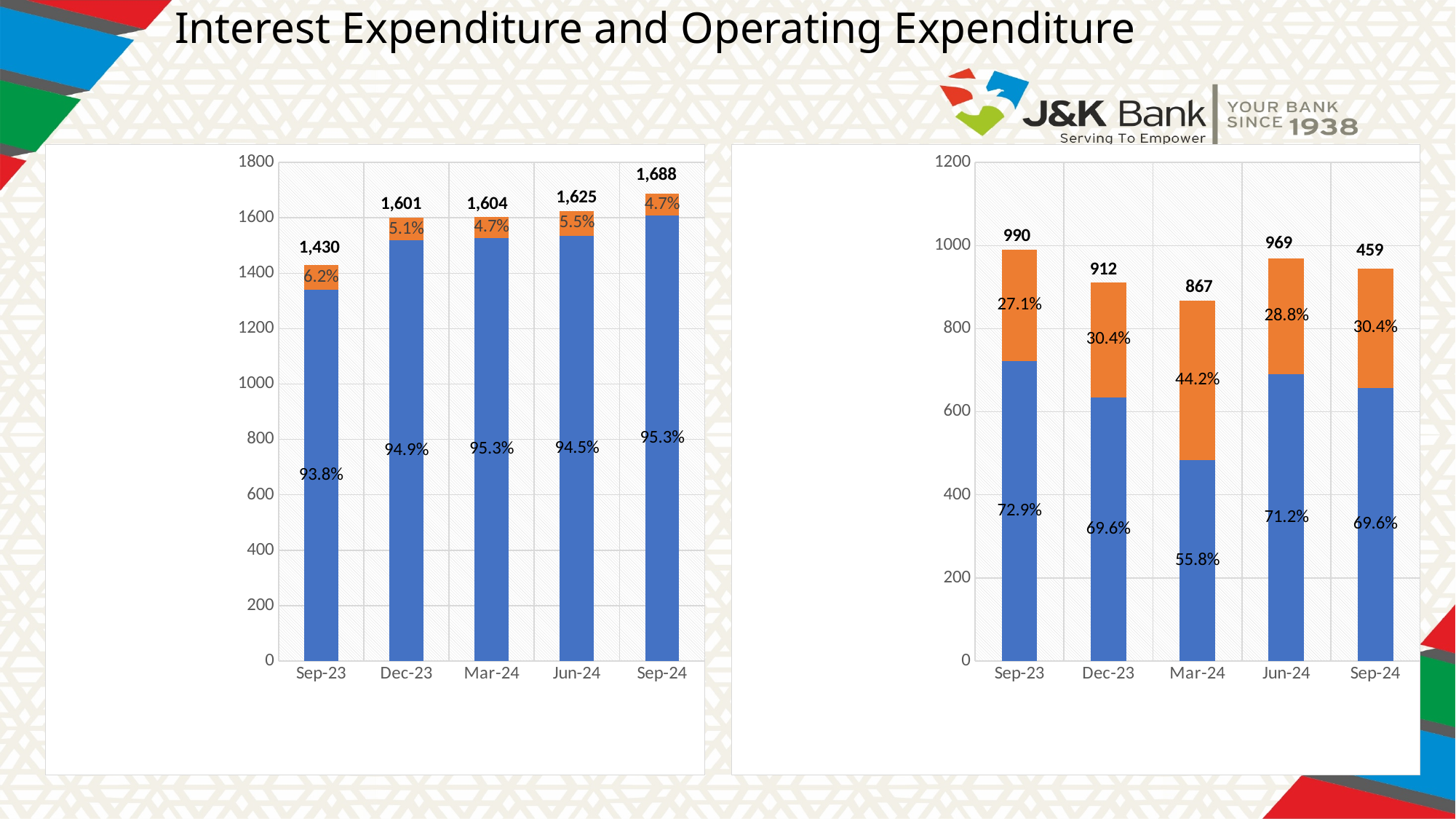
In the right chart, what percentage is labelled on the orange segment for Mar-24? 44.2% In the right chart, what is the total value labelled for Sep-23? 990 In the left chart, what is the total value labelled for Sep-24? 1,688 In the left chart, what percentage is labelled on the orange segment for Sep-23? 6.2% What kind of chart is the right chart? bar chart In the left chart, what percentage is labelled on the blue segment for Mar-24? 95.3% In the right chart, which is larger, the total for Dec-23 or the total for Jun-24? Jun-24 How many periods are shown on the x axis of the left chart? 5 In the left chart, what is the difference between the Sep-24 total and the Sep-23 total? 258 In the left chart, which period has the highest total? Sep-24 In the left chart, do the bar totals rise or fall from Sep-23 to Sep-24? rise In the left chart, which period has the lowest total? Sep-23